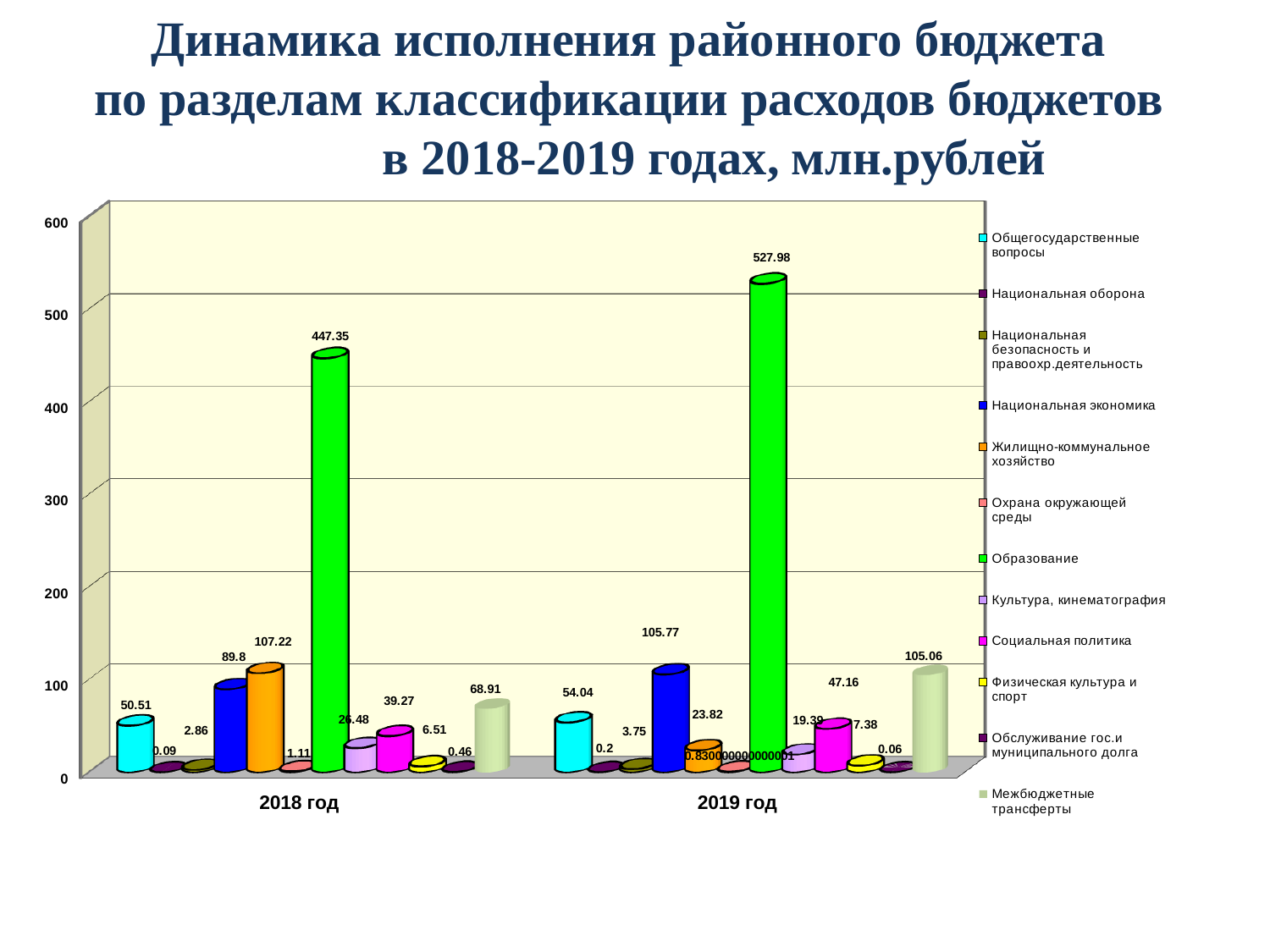
What is the difference between the Национальная экономика values for 2019 год and 2018 год? 15.97 How many series does the legend list? 12 What is the value for Образование in 2019 год? 527.98 What is the value for Социальная политика in 2018 год? 39.27 What kind of chart is shown on the slide? bar chart Is the value for Образование in 2019 год greater or less than 500? greater How many year categories are shown on the x axis? 2 What is the value for Образование in 2018 год? 447.35 What is the value for Межбюджетные трансферты in 2019 год? 105.06 Which series has the highest value in 2019 год? Образование Is the value for Жилищно-коммунальное хозяйство larger in 2018 год or in 2019 год? 2018 год By how much did the value for Образование increase from 2018 год to 2019 год? 80.63